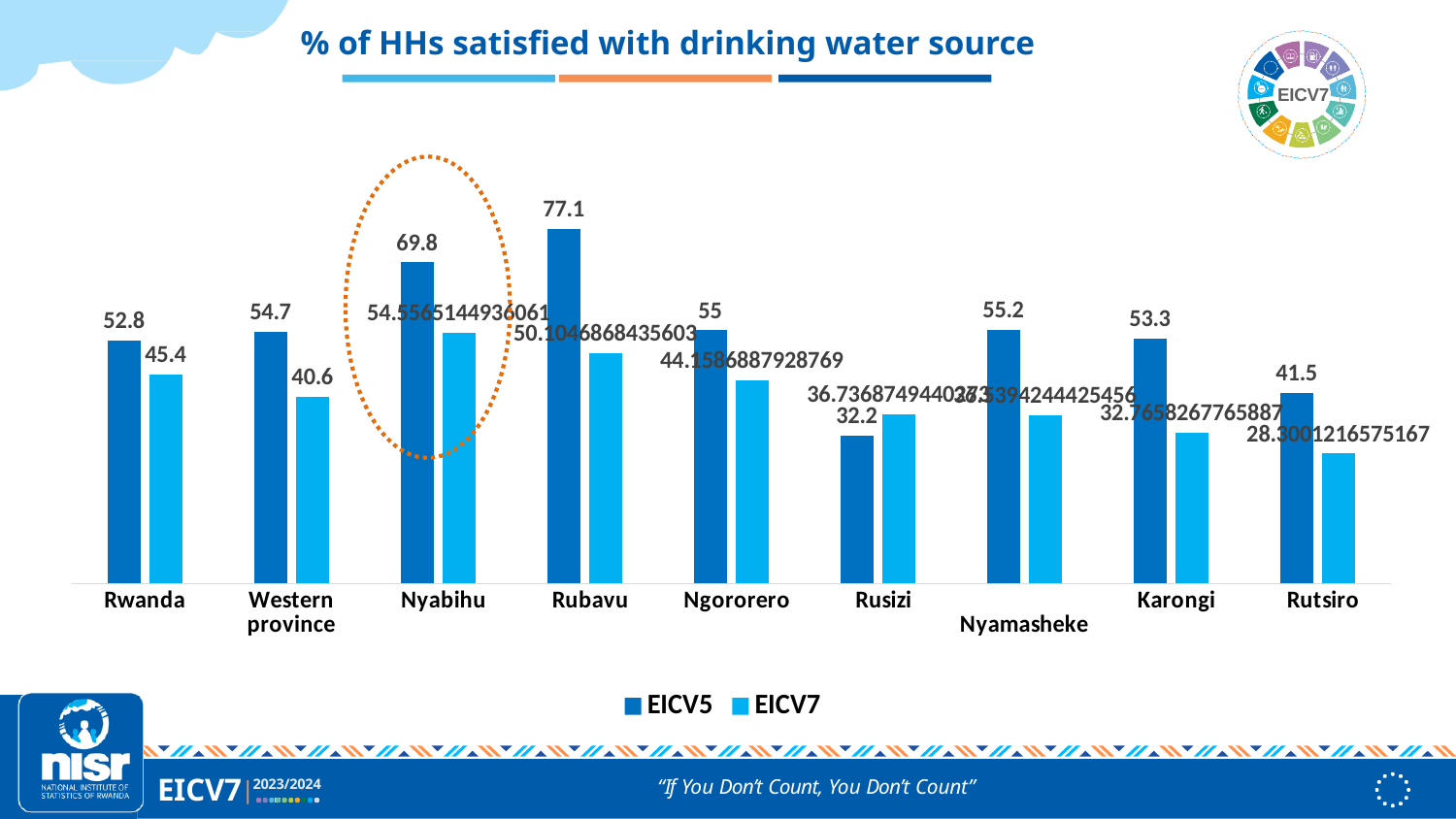
Which category has the lowest EICV5 value? Rusizi What is the EICV5 value for Rwanda? 52.8 How many categories are shown on the x axis? 9 What is the EICV7 value for Western province? 40.6 For Rusizi, which is larger: the EICV5 value or the EICV7 value? EICV7 Which category has the lowest EICV7 value? Rutsiro Which category has the highest EICV5 value? Rubavu What is the difference between the EICV5 and EICV7 values for Rwanda? 7.4 What kind of chart is shown on the slide? Bar chart How many series does the legend list? 2 What is the EICV5 value for Rusizi? 32.2 What is the EICV5 value for Nyabihu? 69.8